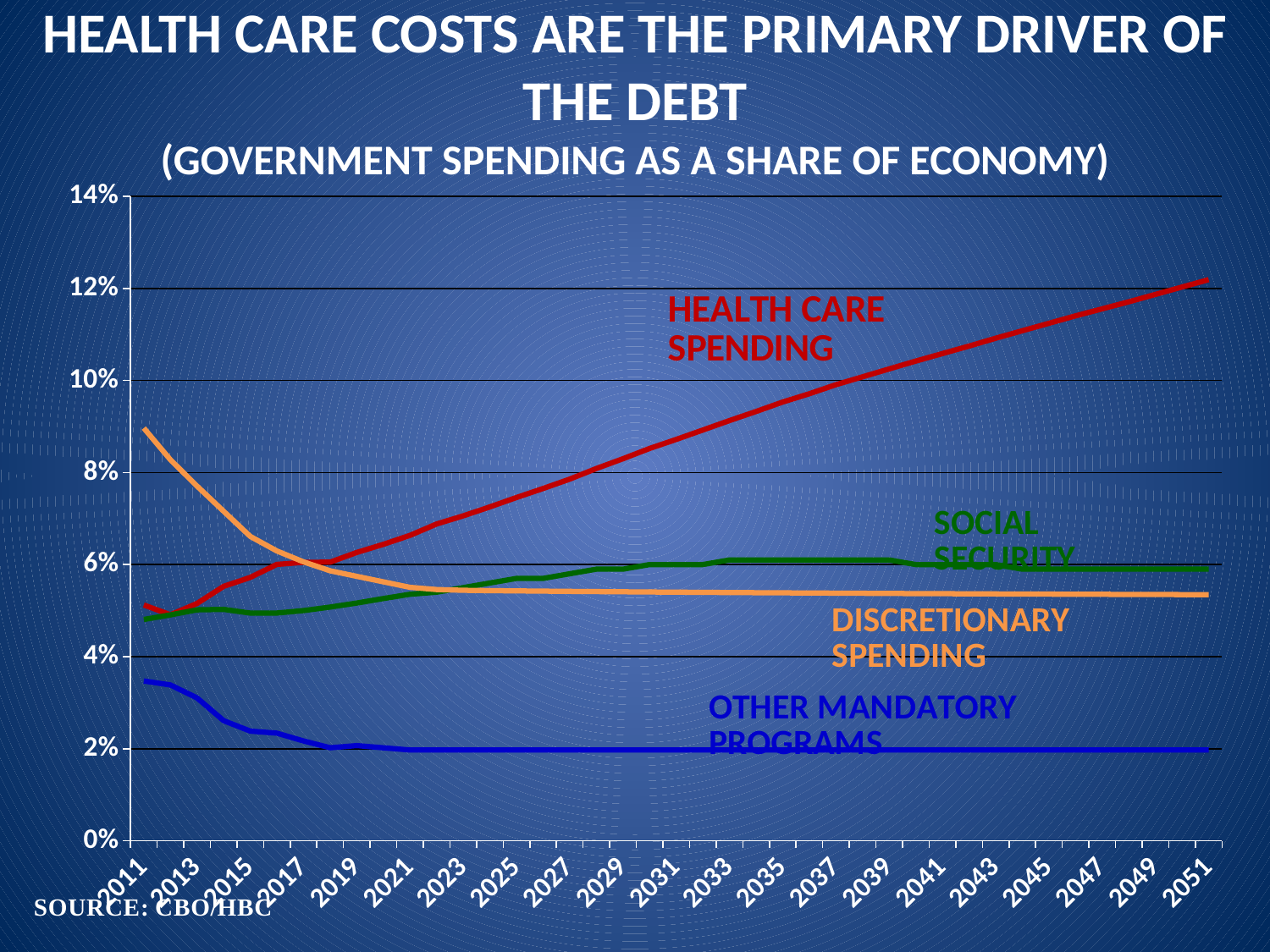
Which series has the highest value in 2051? Health Care Spending Is the value for Other Mandatory Programs in 2051 greater or less than 4%? less Does Other Mandatory Programs rise or fall between 2011 and 2021? fall Is the value for Discretionary Spending in 2011 greater or less than 8%? greater How many data series are labeled on the chart? 4 In 2011, which is larger: Discretionary Spending or Health Care Spending? Discretionary Spending Which series has the lowest value in 2051? Other Mandatory Programs What source is cited for the chart? CBO/HBC Does Health Care Spending rise or fall from 2011 to 2051? rise Is the value for Health Care Spending in 2051 greater or less than 10%? greater Does Discretionary Spending rise or fall from 2011 to 2051? fall What kind of chart is shown on the slide? line chart